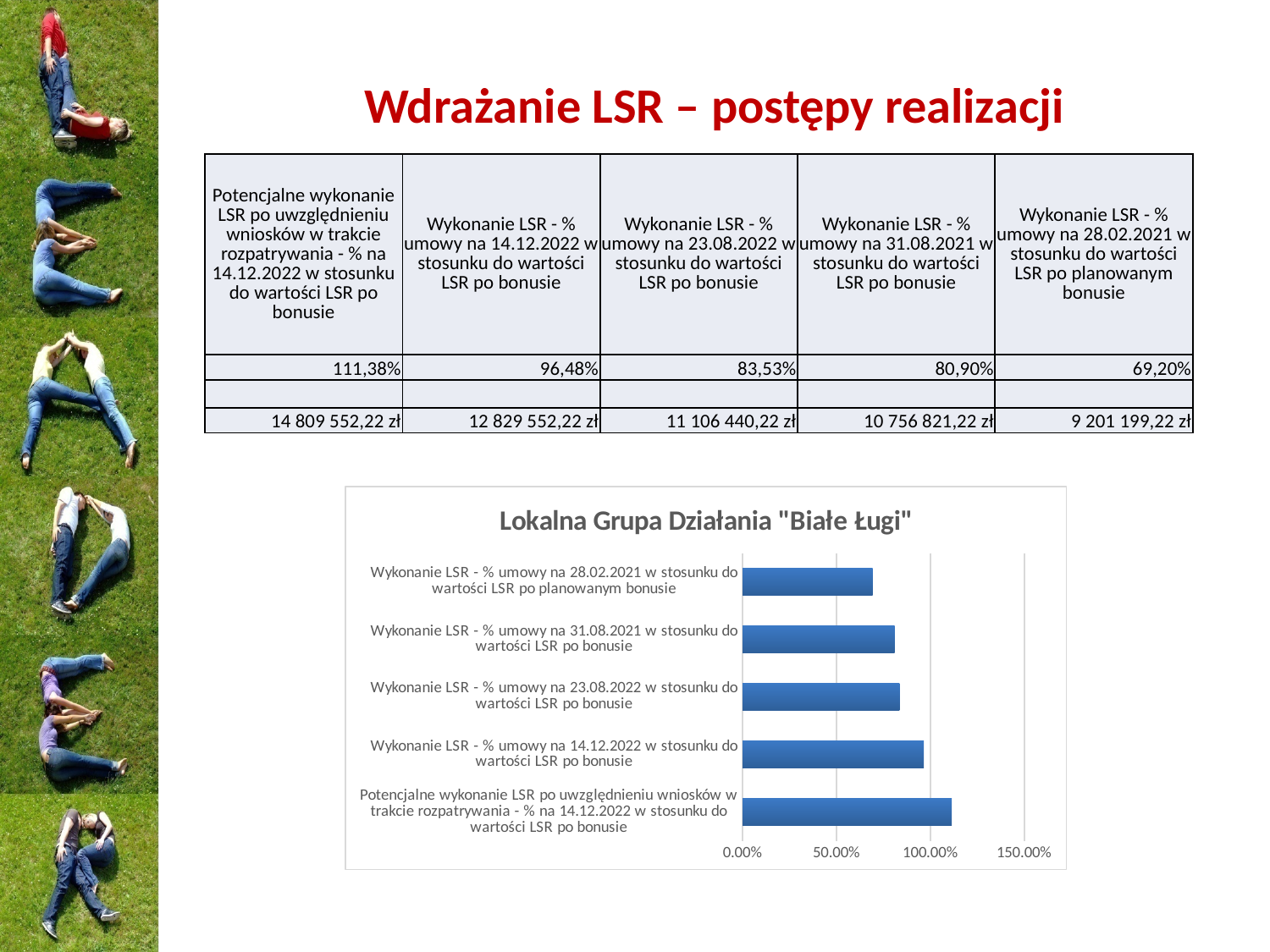
What is the title of the chart? Lokalna Grupa Działania "Białe Ługi" How many bars does the chart contain? 5 Which category has the shortest bar in the chart? Wykonanie LSR - % umowy na 28.02.2021 w stosunku do wartości LSR po planowanym bonusie Is the bar for 'Potencjalne wykonanie LSR po uwzględnieniu wniosków w trakcie rozpatrywania' greater or less than 100.00%? greater What type of chart is shown on the slide? bar chart Is the bar for 'Wykonanie LSR - % umowy na 23.08.2022 w stosunku do wartości LSR po bonusie' greater or less than 50.00%? greater Which bar is longer: 'Wykonanie LSR - % umowy na 14.12.2022' or 'Wykonanie LSR - % umowy na 28.02.2021'? Wykonanie LSR - % umowy na 14.12.2022 According to the table on the slide, what value is plotted for 'Wykonanie LSR - % umowy na 14.12.2022 w stosunku do wartości LSR po bonusie'? 96,48% Which category has the longest bar in the chart? Potencjalne wykonanie LSR po uwzględnieniu wniosków w trakcie rozpatrywania - % na 14.12.2022 w stosunku do wartości LSR po bonusie Is the bar for 'Wykonanie LSR - % umowy na 28.02.2021 w stosunku do wartości LSR po planowanym bonusie' greater or less than 100.00%? less According to the table on the slide, what value is plotted for 'Wykonanie LSR - % umowy na 31.08.2021 w stosunku do wartości LSR po bonusie'? 80,90% What is the highest tick value shown on the chart's horizontal axis? 150.00%